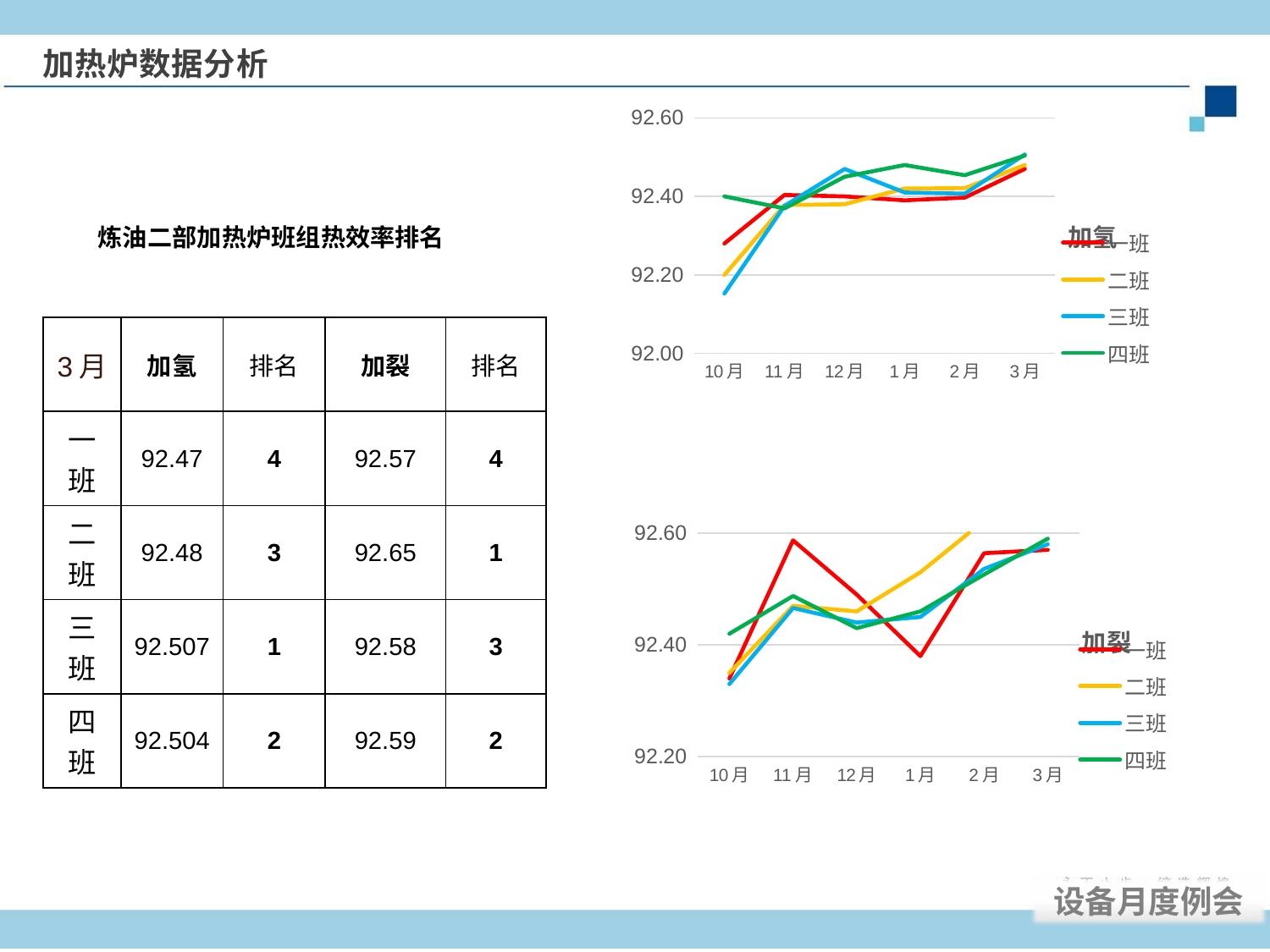
In the bottom chart titled 加裂, is the value for 三班 in 10月 greater or less than 92.40? less In the top chart titled 加氢, does the value for 三班 rise or fall overall from 10月 to 3月? rise In the top chart titled 加氢, is the value for 四班 in 10月 greater or less than 92.20? greater In the top chart titled 加氢, which series has the lowest value in 10月? 三班 In the top chart titled 加氢, which series has the highest value in 10月? 四班 What kind of chart is the top chart titled 加氢? line chart In the top chart titled 加氢, is the value for 三班 in 10月 greater or less than 92.20? less In the bottom chart titled 加裂, which is larger in 11月, 一班 or 三班? 一班 In the bottom chart titled 加裂, which series has the highest value in 11月? 一班 How many months are shown on the x axis of the top chart titled 加氢? 6 How many series does the legend of the bottom chart titled 加裂 list? 4